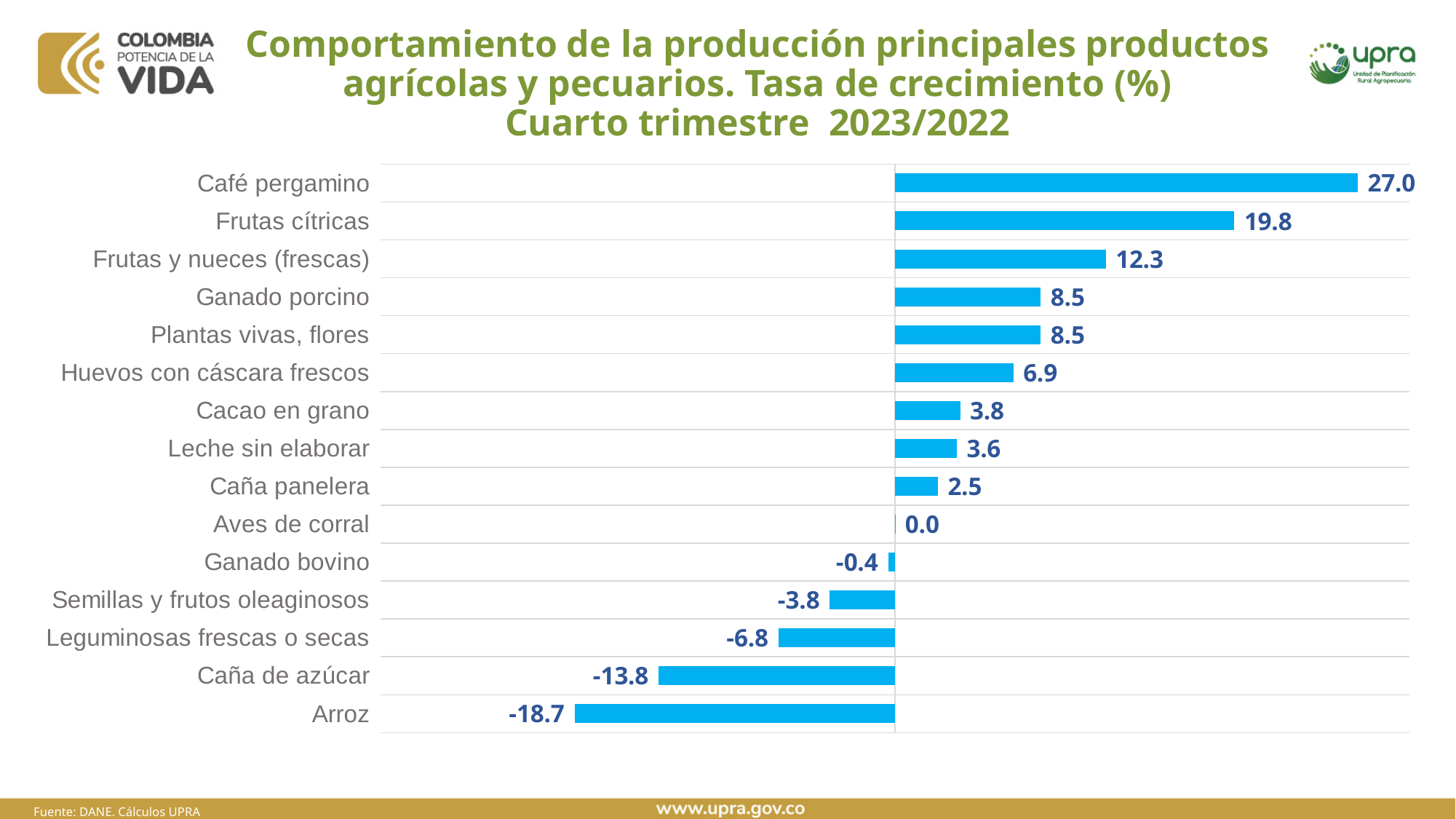
What is the growth rate shown for Café pergamino? 27.0 What is the value shown for Ganado bovino? -0.4 Which category has the highest value? Café pergamino How many categories are shown in the chart? 15 What is the value shown for Caña de azúcar? -13.8 What is the value shown for Huevos con cáscara frescos? 6.9 Which is larger, the value for Cacao en grano or the value for Leche sin elaborar? Cacao en grano What is the difference between the values for Café pergamino and Frutas cítricas? 7.2 Which category has the lowest value? Arroz Which category has a value of exactly 0.0? Aves de corral What kind of chart is shown on the slide? Bar chart What is the difference between the values for Arroz and Caña de azúcar? 4.9